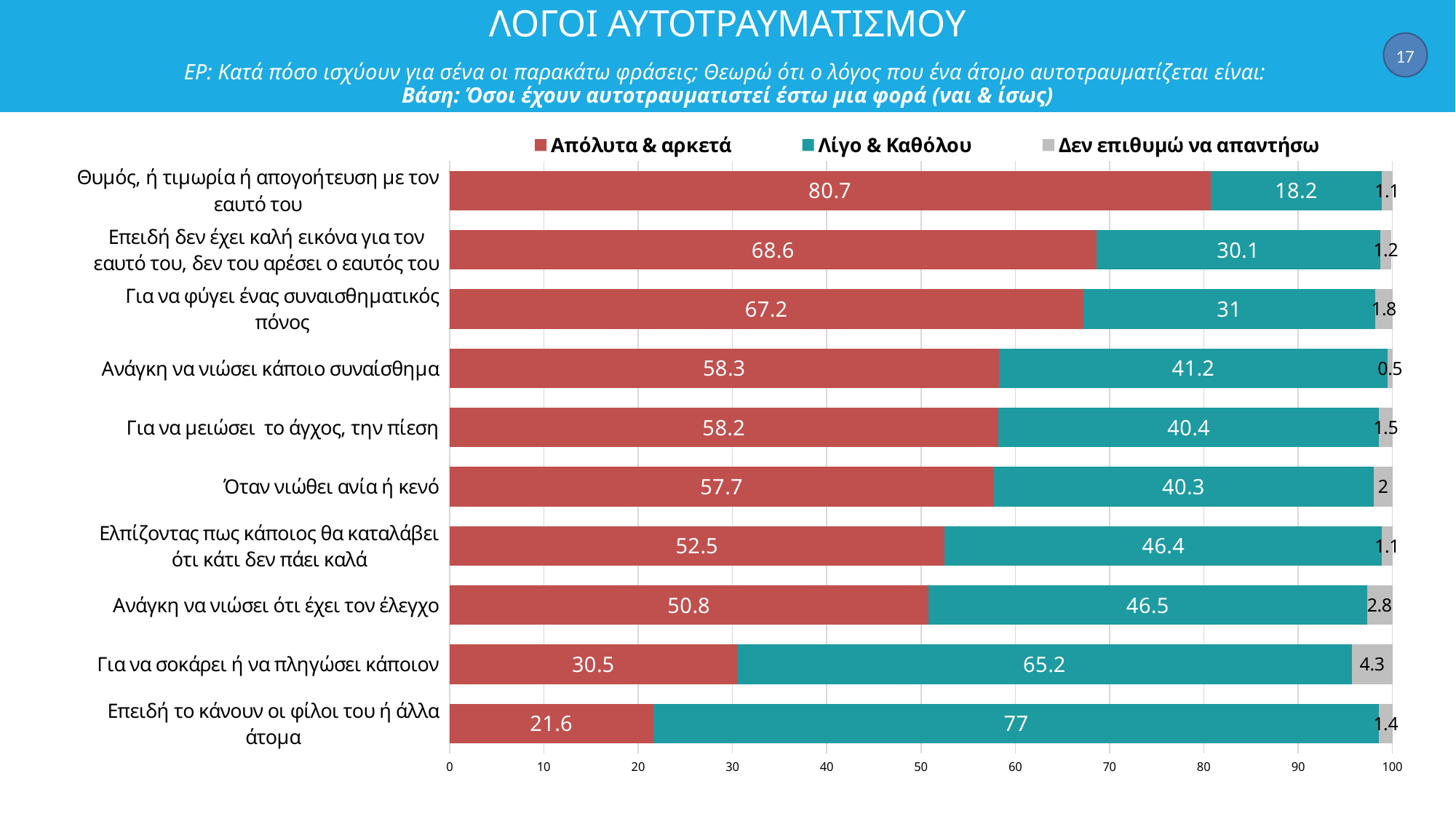
Which category has the lowest "Απόλυτα & αρκετά" value? Επειδή το κάνουν οι φίλοι του ή άλλα άτομα How many series does the legend list? 3 What is the difference between the "Απόλυτα & αρκετά" values for "Θυμός, ή τιμωρία ή απογοήτευση με τον εαυτό του" and "Επειδή δεν έχει καλή εικόνα για τον εαυτό του, δεν του αρέσει ο εαυτός του"? 12.1 What is the "Λίγο & Καθόλου" value for "Για να σοκάρει ή να πληγώσει κάποιον"? 65.2 What is the total of the stacked bar for "Επειδή το κάνουν οι φίλοι του ή άλλα άτομα"? 100 Which is larger: the "Λίγο & Καθόλου" value for "Ανάγκη να νιώσει κάποιο συναίσθημα" or for "Για να φύγει ένας συναισθηματικός πόνος"? Ανάγκη να νιώσει κάποιο συναίσθημα How many categories are shown in the chart? 10 What is the "Δεν επιθυμώ να απαντήσω" value for "Ανάγκη να νιώσει ότι έχει τον έλεγχο"? 2.8 Which category has the highest "Απόλυτα & αρκετά" value? Θυμός, ή τιμωρία ή απογοήτευση με τον εαυτό του What kind of chart is shown on the slide? Stacked bar chart Which category has the highest "Δεν επιθυμώ να απαντήσω" value? Για να σοκάρει ή να πληγώσει κάποιον What is the "Απόλυτα & αρκετά" value for "Θυμός, ή τιμωρία ή απογοήτευση με τον εαυτό του"? 80.7